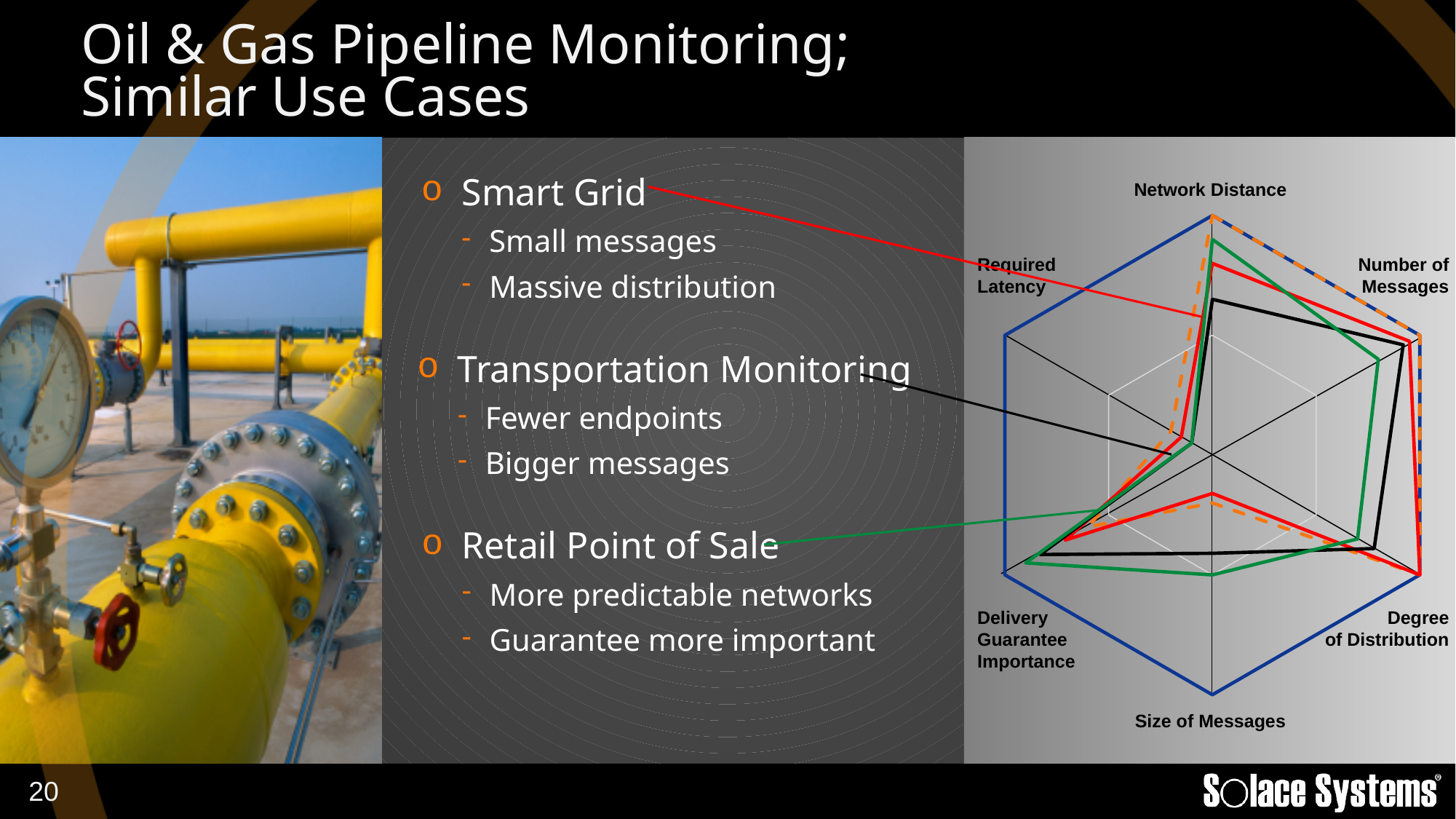
Which axis of the radar chart is labelled at the top? Network Distance Which axis of the radar chart is labelled at the bottom? Size of Messages On the Network Distance axis, which extends further from the centre: the green line or the black line? Green On the Size of Messages axis, which extends further from the centre: the red line or the black line? Black On the Delivery Guarantee Importance axis, which extends further from the centre: the green line or the red line? Green How many axes (categories) does the radar chart have? 6 Which colour of line in the radar chart is connected to the 'Transportation Monitoring' bullet? Black What kind of chart is shown on the right side of the slide? Radar chart